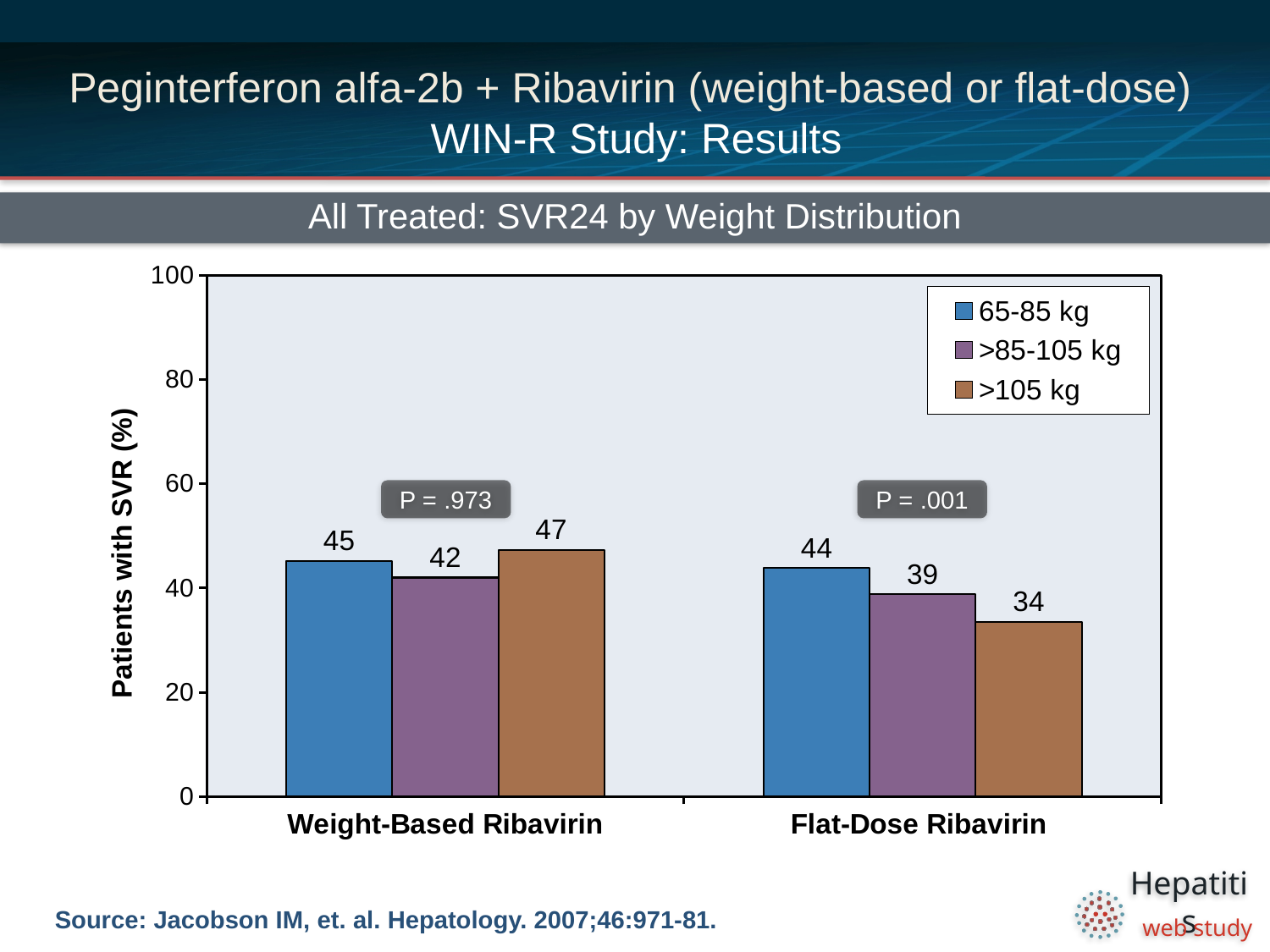
What is the SVR rate for the >105 kg group with Flat-Dose Ribavirin? 34 What is the SVR rate for the 65-85 kg group with Weight-Based Ribavirin? 45 What is the SVR rate for the >85-105 kg group with Flat-Dose Ribavirin? 39 How many series does the legend list? 3 Is the SVR rate for the >85-105 kg group with Weight-Based Ribavirin greater or less than 40? greater Which weight group has the highest SVR rate with Weight-Based Ribavirin? >105 kg What is the P value shown for the Flat-Dose Ribavirin group? P = .001 Which weight group has the lowest SVR rate with Flat-Dose Ribavirin? >105 kg What kind of chart is shown on the slide? Bar chart Which is larger: the SVR rate for the >105 kg group with Weight-Based Ribavirin or with Flat-Dose Ribavirin? Weight-Based Ribavirin How many treatment categories are shown on the x axis? 2 What is the difference in SVR rate between the 65-85 kg and >105 kg groups with Flat-Dose Ribavirin? 10